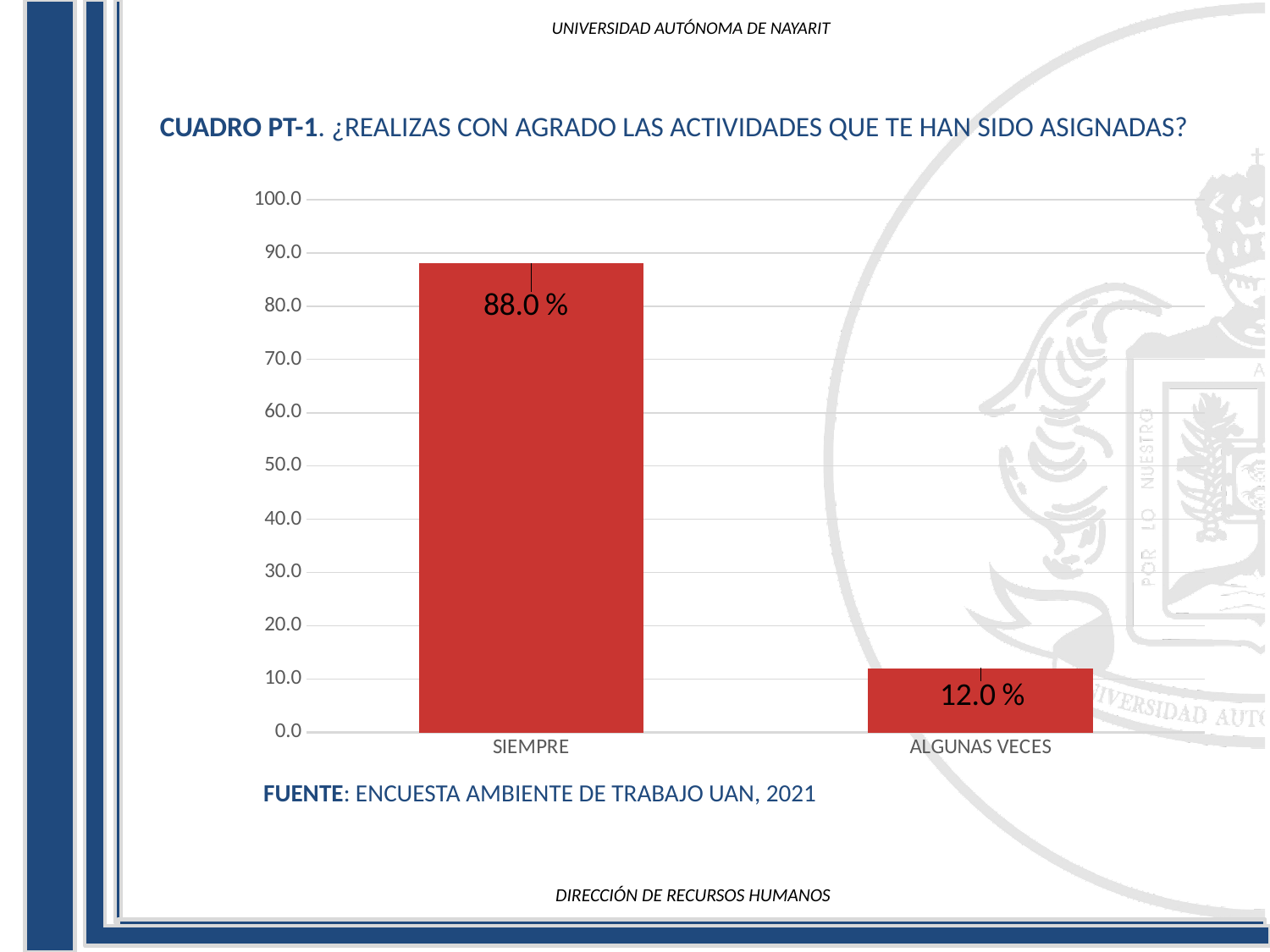
Which category has the lowest value? ALGUNAS VECES What kind of chart is shown on the slide? bar chart Which is larger, the value for SIEMPRE or the value for ALGUNAS VECES? SIEMPRE What colour are the bars in the chart? red Is the value for SIEMPRE greater or less than 80.0? greater Which category has the highest value? SIEMPRE What is the value for ALGUNAS VECES? 12.0 % What is the difference between the values for SIEMPRE and ALGUNAS VECES? 76.0 % What is the value for SIEMPRE? 88.0 % Is the value for ALGUNAS VECES greater or less than 20.0? less What is the source cited below the chart? ENCUESTA AMBIENTE DE TRABAJO UAN, 2021 How many categories are shown on the x axis? 2